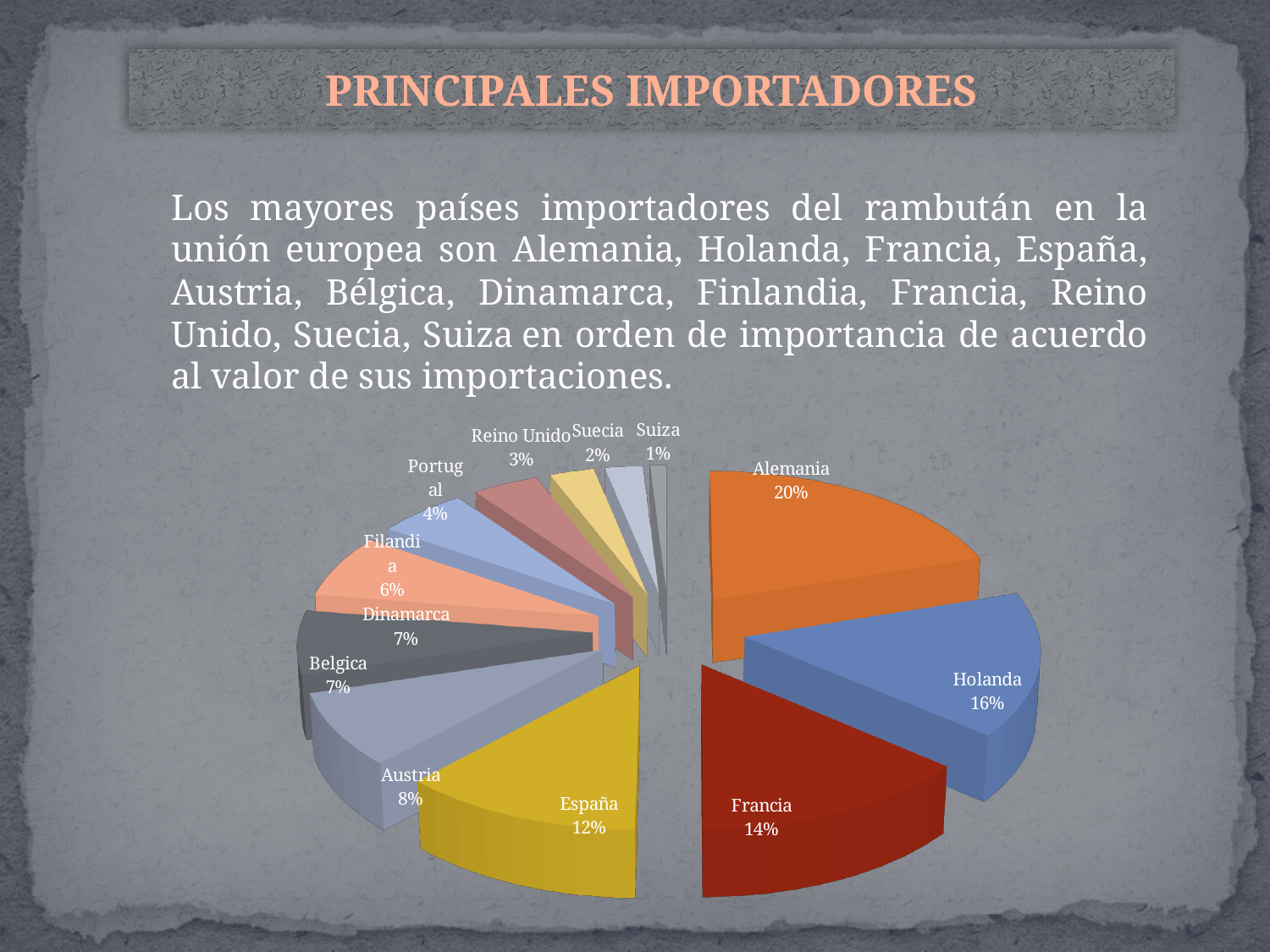
What is the value shown for Reino Unido? 3% Which has a larger share, Holanda or España? Holanda What percentage is shown for España? 12% What is the title of the slide containing the chart? PRINCIPALES IMPORTADORES Which country has the smallest slice of the pie? Suiza What share of the pie does Alemania have? 20% Which country has the largest slice of the pie? Alemania What is the combined share of Belgica and Dinamarca? 14% What is the value shown for Holanda? 16% How many slices does the pie chart have? 12 What kind of chart is shown on the slide? pie chart What is the difference between the shares of Alemania and Francia? 6%